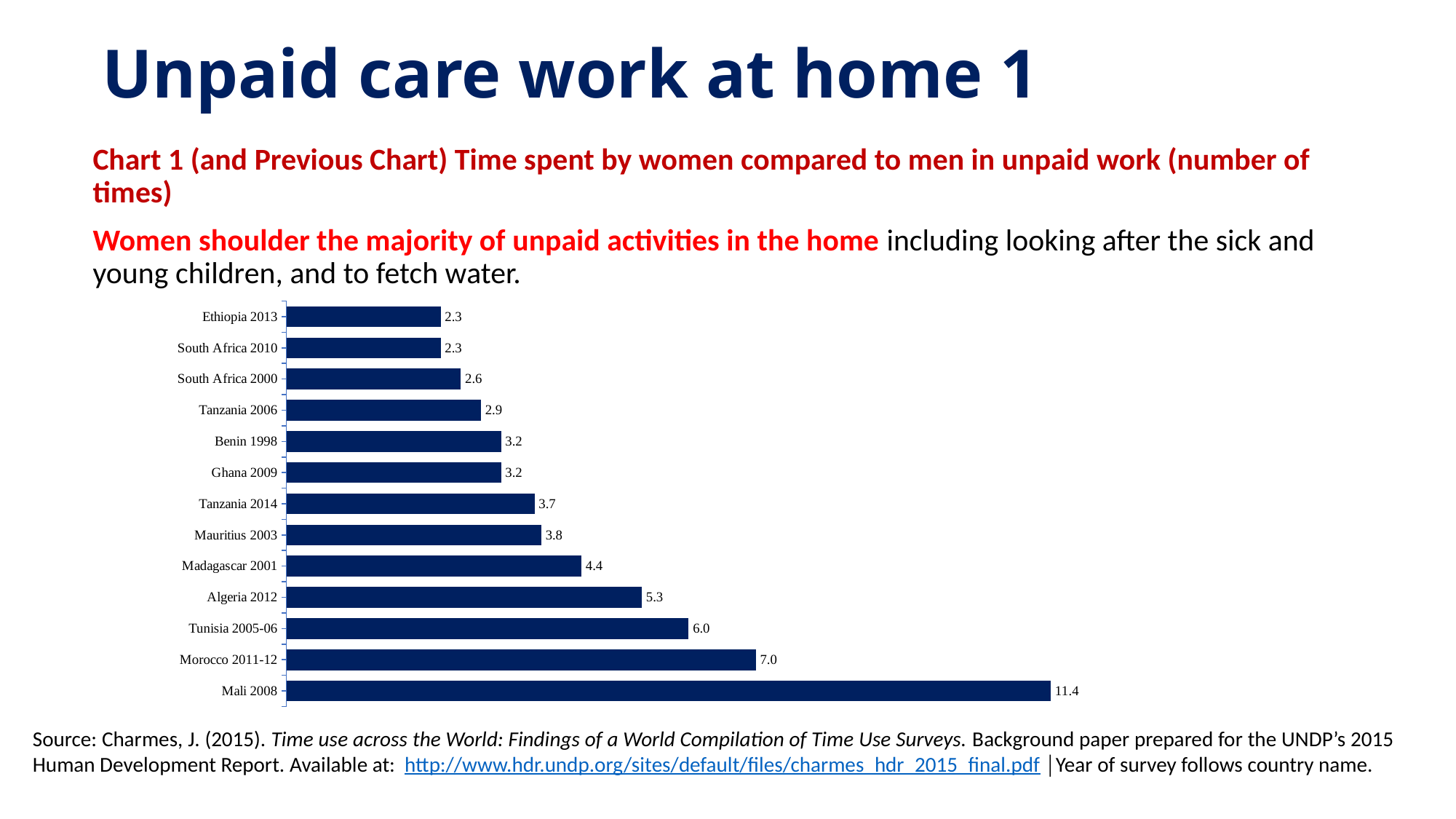
What colour are the bars in the chart? Dark blue What is the value for Tanzania 2014? 3.7 What is the value for Mali 2008? 11.4 How many categories are shown in the chart? 13 Which is larger, the value for Madagascar 2001 or the value for Mauritius 2003? Madagascar 2001 Which category has the highest value? Mali 2008 What kind of chart is shown on the slide? Bar chart What is the value for Tunisia 2005-06? 6.0 Which is larger, the value for South Africa 2000 or the value for Tanzania 2006? Tanzania 2006 What is the difference between the values for Mali 2008 and Morocco 2011-12? 4.4 What is the difference between the values for Morocco 2011-12 and Algeria 2012? 1.7 What is the value for Ghana 2009? 3.2